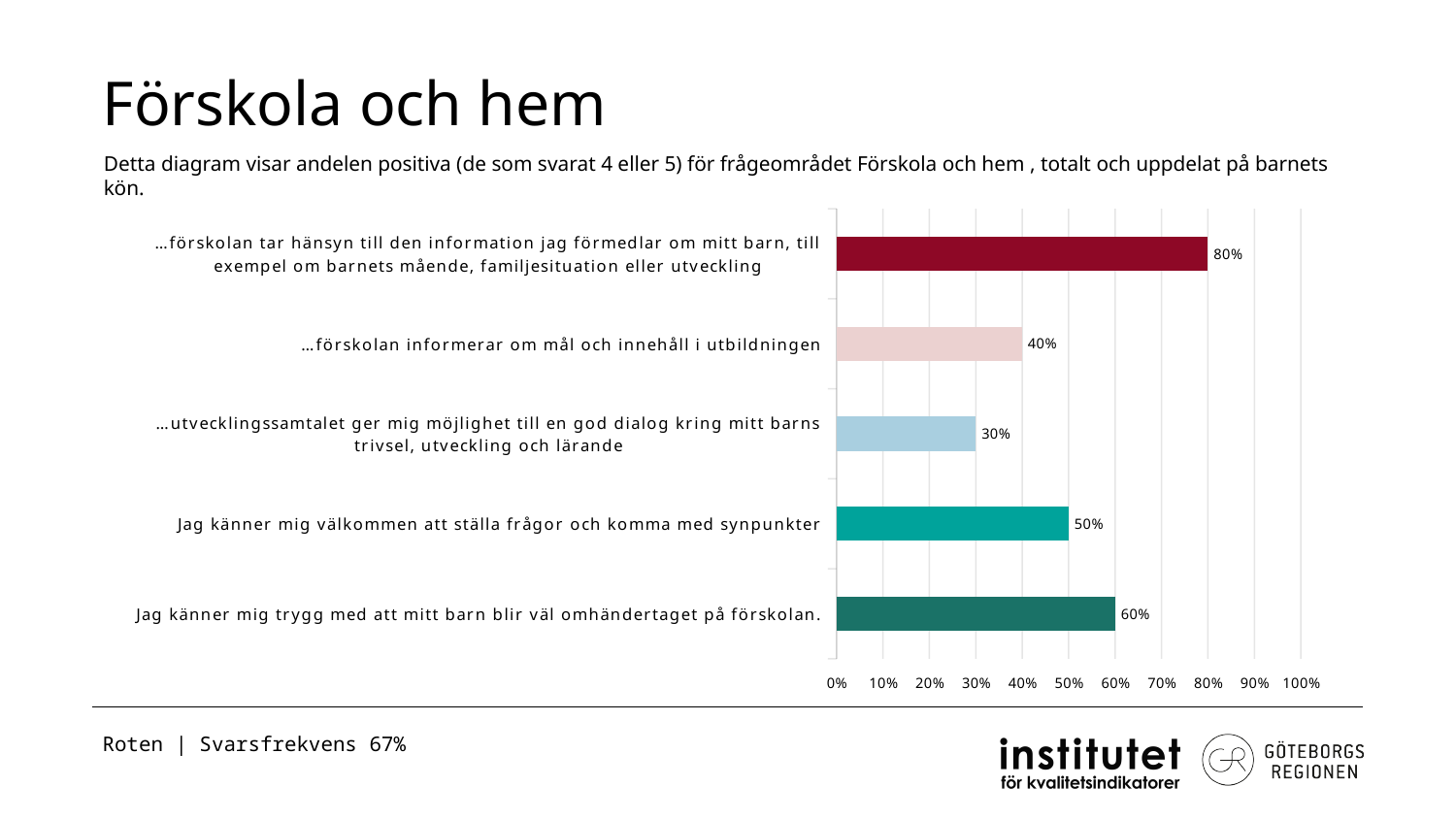
How many categories are shown in the chart? 5 Which category has the highest value? …förskolan tar hänsyn till den information jag förmedlar om mitt barn, till exempel om barnets mående, familjesituation eller utveckling What is the value for "Jag känner mig trygg med att mitt barn blir väl omhändertaget på förskolan."? 60% What is the title of the slide? Förskola och hem What is the maximum value shown on the x axis? 100% Which is larger: the value for "Jag känner mig välkommen att ställa frågor och komma med synpunkter" or the value for "…förskolan informerar om mål och innehåll i utbildningen"? Jag känner mig välkommen att ställa frågor och komma med synpunkter What is the difference between the highest value (80%) and the lowest value (30%)? 50% What is the value for "Jag känner mig välkommen att ställa frågor och komma med synpunkter"? 50% Is the value for "Jag känner mig trygg med att mitt barn blir väl omhändertaget på förskolan." greater or less than 50%? greater What is the value for "…förskolan informerar om mål och innehåll i utbildningen"? 40% Which category has the lowest value? …utvecklingssamtalet ger mig möjlighet till en god dialog kring mitt barns trivsel, utveckling och lärande What kind of chart is shown on the slide? Bar chart